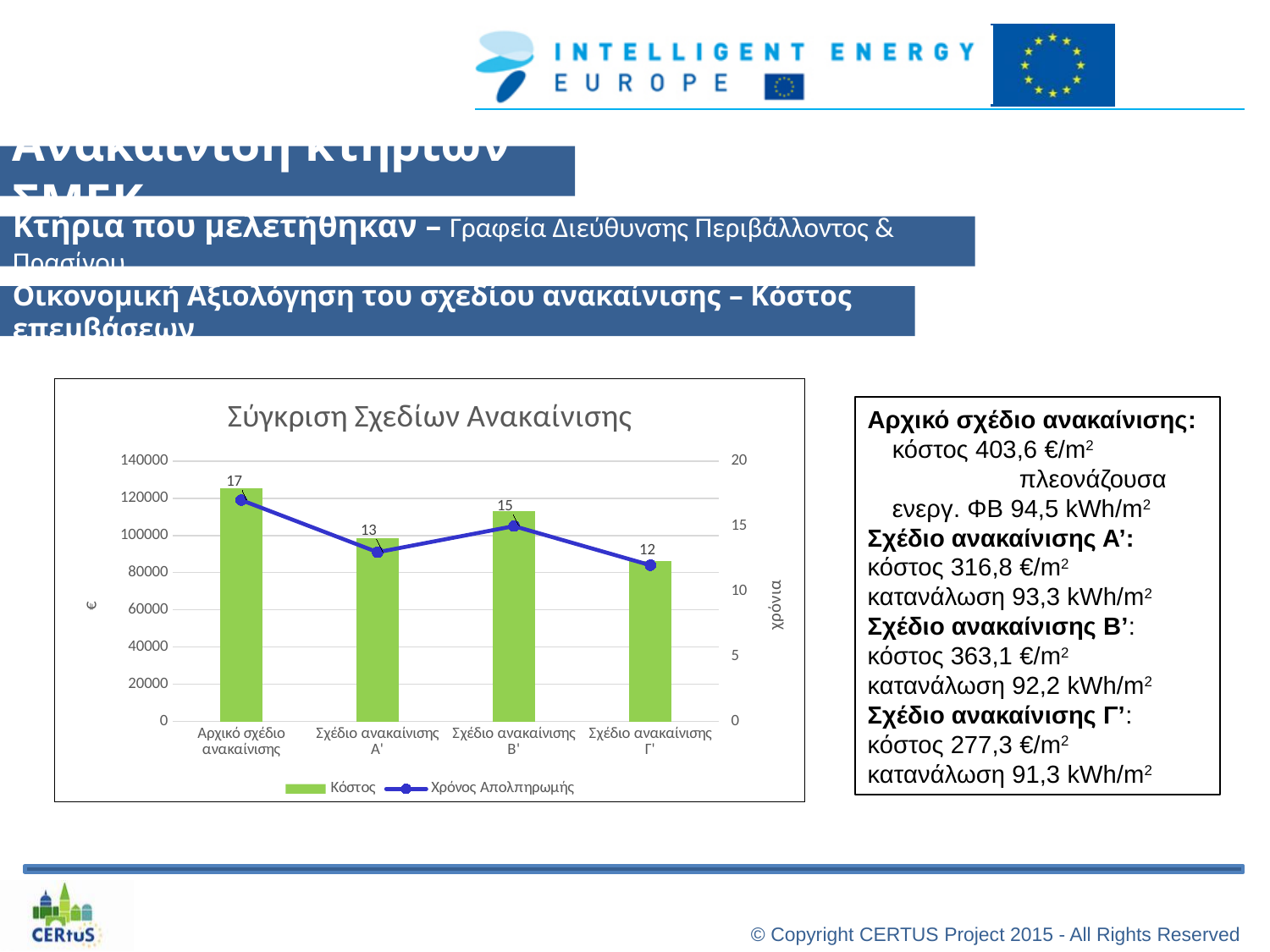
What is the difference in payback time between Αρχικό σχέδιο ανακαίνισης and Σχέδιο ανακαίνισης Γ'? 5 Is the cost (Κόστος) for Σχέδιο ανακαίνισης Γ' greater or less than 100000? less What is the payback time (Χρόνος Απολπηρωμής) for Αρχικό σχέδιο ανακαίνισης? 17 Which has the longer payback time, Σχέδιο ανακαίνισης Α' or Σχέδιο ανακαίνισης Β'? Σχέδιο ανακαίνισης Β' How many series does the chart legend list? 2 How many renovation plans are shown on the x axis of the chart? 4 What is the payback time (Χρόνος Απολπηρωμής) for Σχέδιο ανακαίνισης Γ'? 12 Which renovation plan has the lowest cost (Κόστος) bar? Σχέδιο ανακαίνισης Γ' Is the cost (Κόστος) for Αρχικό σχέδιο ανακαίνισης greater or less than 120000? greater What is the title of the chart? Σύγκριση Σχεδίων Ανακαίνισης Which renovation plan has the highest payback time (Χρόνος Απολπηρωμής)? Αρχικό σχέδιο ανακαίνισης What kind of chart is used to show the cost (Κόστος) series? bar chart